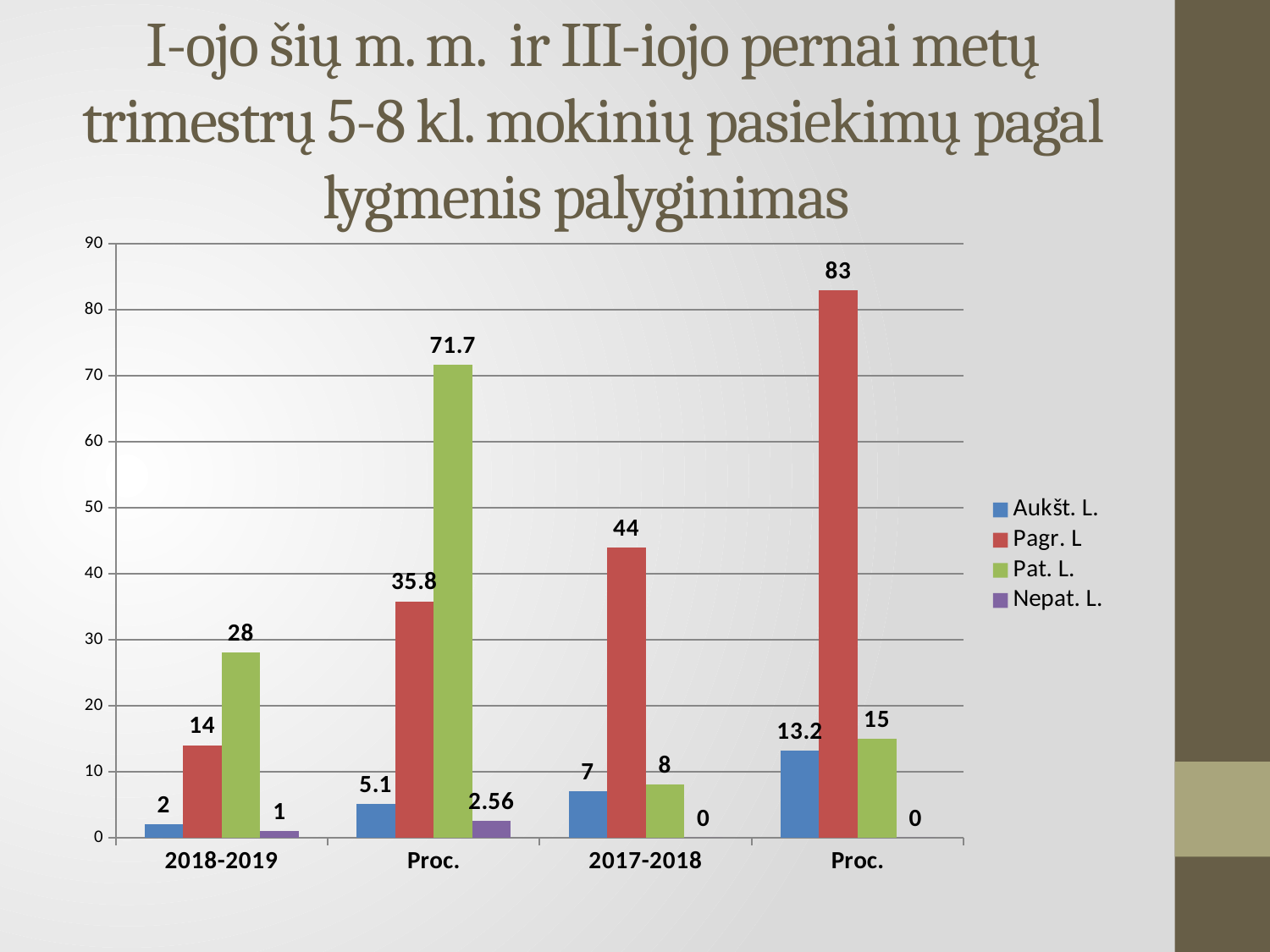
What is the value for Pagr. L in the 2017-2018 category? 44 Which series has the highest value in the last Proc. category (the one following 2017-2018)? Pagr. L Which series has the lowest value in the 2018-2019 category? Nepat. L. What kind of chart is shown on the slide? bar chart What is the difference between the Pat. L. value and the Pagr. L value in the first Proc. category (the one following 2018-2019)? 35.9 Which legend entry is shown in green? Pat. L. How many series does the legend list? 4 What is the value for Nepat. L. in the first Proc. category (the one following 2018-2019)? 2.56 What is the value for Aukšt. L. in the last Proc. category (the one following 2017-2018)? 13.2 How many categories are shown along the x axis? 4 Which is larger: the Pagr. L value for 2018-2019 or the Pagr. L value for 2017-2018? 2017-2018 What is the value for Pat. L. in the 2018-2019 category? 28